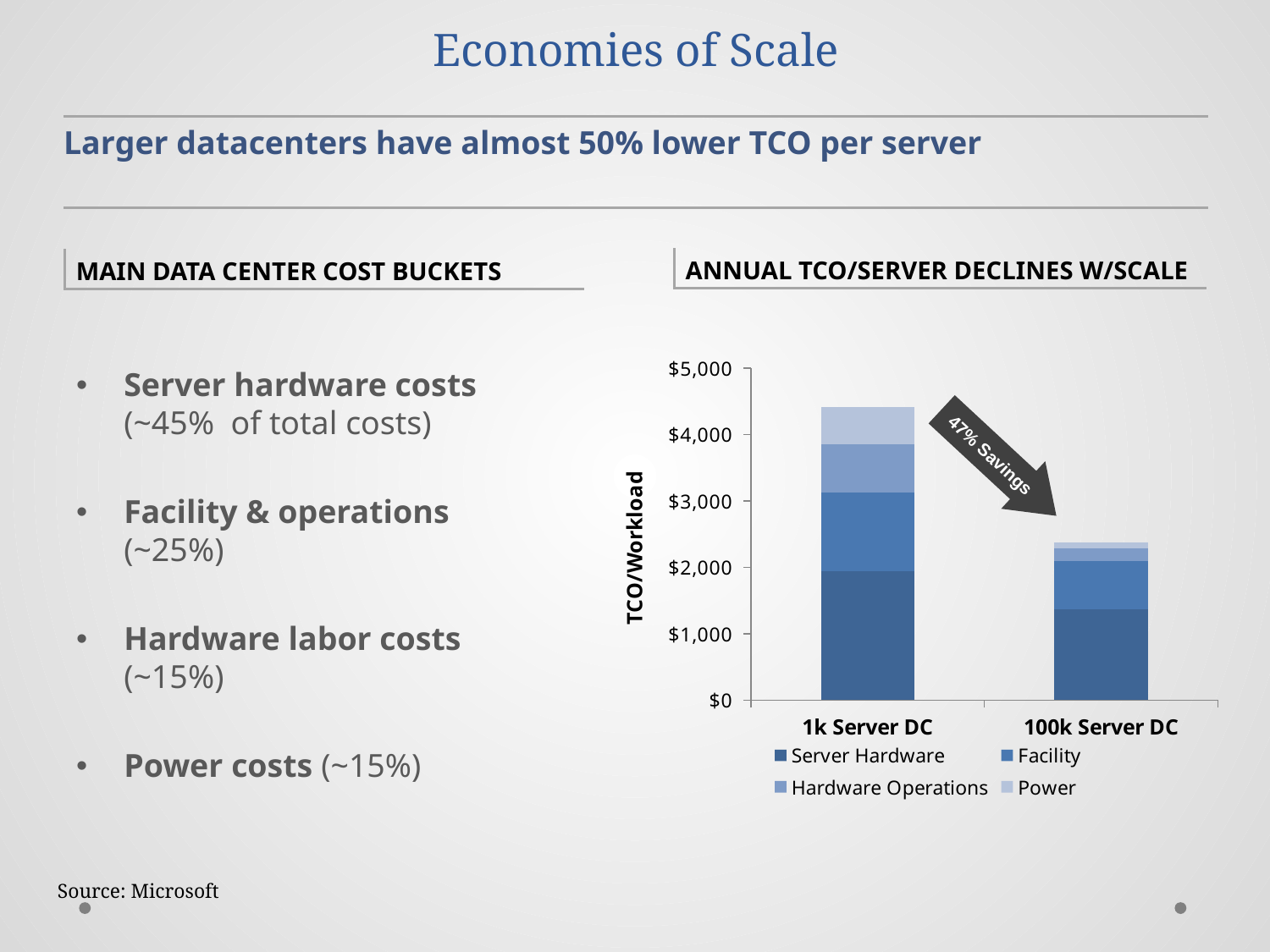
Is the total bar for 1k Server DC greater or less than $4,000? greater What percentage savings does the arrow annotation on the chart state? 47% Savings Is the total bar for 100k Server DC greater or less than $3,000? less Does the total TCO/Workload rise or fall from 1k Server DC to 100k Server DC? fall Is the Server Hardware segment for 100k Server DC greater or less than $1,000? greater How many categories are shown on the x axis of the chart? 2 What is the label on the chart's vertical axis? TCO/Workload How many series does the chart's legend list? 4 Which is larger, the total bar for 1k Server DC or for 100k Server DC? 1k Server DC What type of chart is shown under "ANNUAL TCO/SERVER DECLINES W/SCALE"? Stacked bar chart Which category has the higher total TCO/Workload in the chart? 1k Server DC Which category has the lower total TCO/Workload in the chart? 100k Server DC